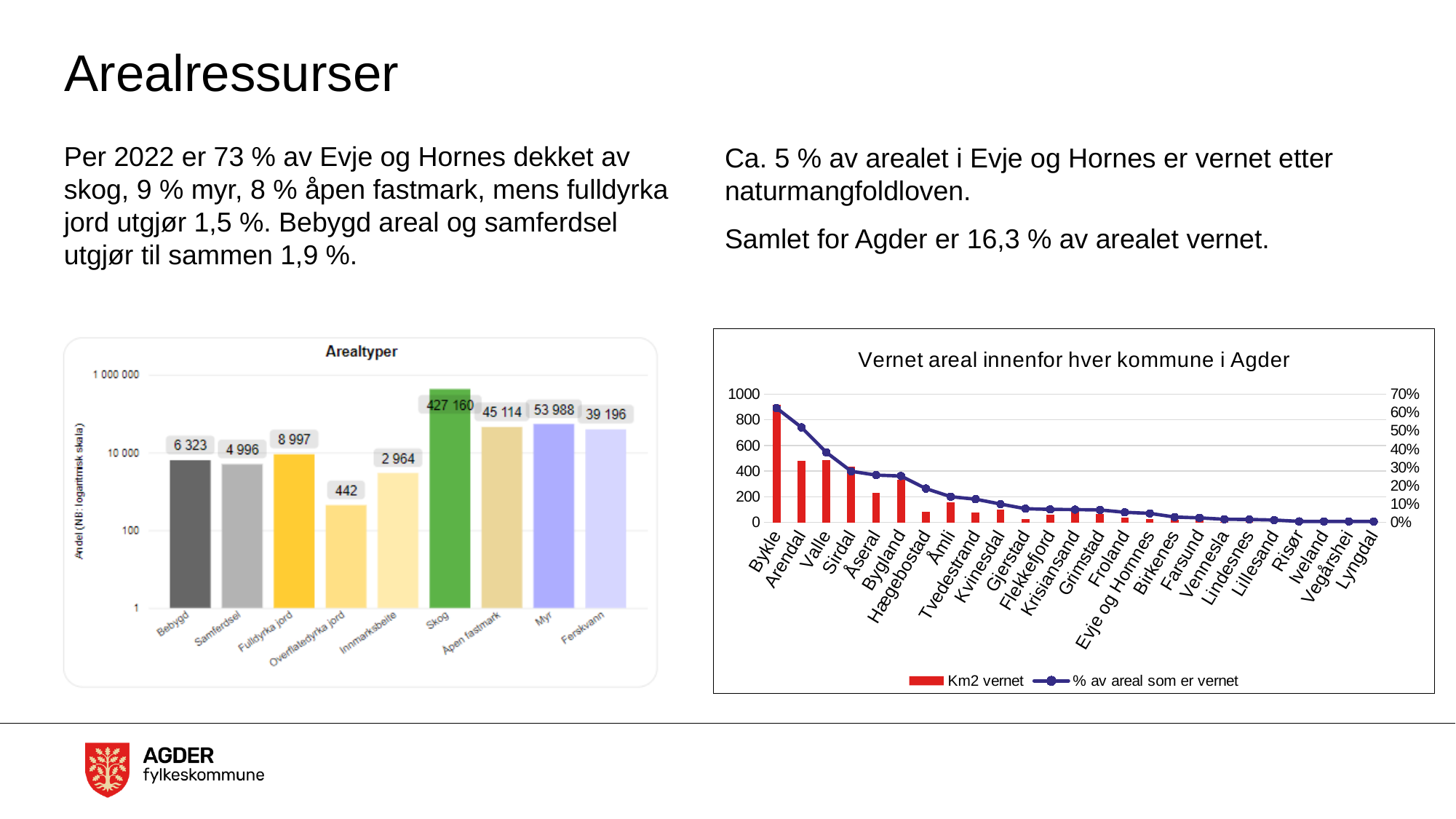
In the chart Vernet areal innenfor hver kommune i Agder, does the % av areal som er vernet line rise or fall from left to right? fall In the Arealtyper chart, what is the value for Myr? 53 988 How many categories are shown in the Arealtyper chart? 9 In the Arealtyper chart, what is the value for Skog? 427 160 In the Arealtyper chart, which category has the lowest value? Overflatedyrka jord In the Arealtyper chart, what is the value for Overflatedyrka jord? 442 In the chart Vernet areal innenfor hver kommune i Agder, which municipality has the highest Km2 vernet? Bykle In the chart Vernet areal innenfor hver kommune i Agder, is the Km2 vernet value for Bykle greater or less than 800? greater In the Arealtyper chart, which category has the highest value? Skog How many series does the legend list in the chart Vernet areal innenfor hver kommune i Agder? 2 In the Arealtyper chart, which is larger, Åpen fastmark or Ferskvann? Åpen fastmark In the Arealtyper chart, what is the difference between Bebygd and Samferdsel? 1 327